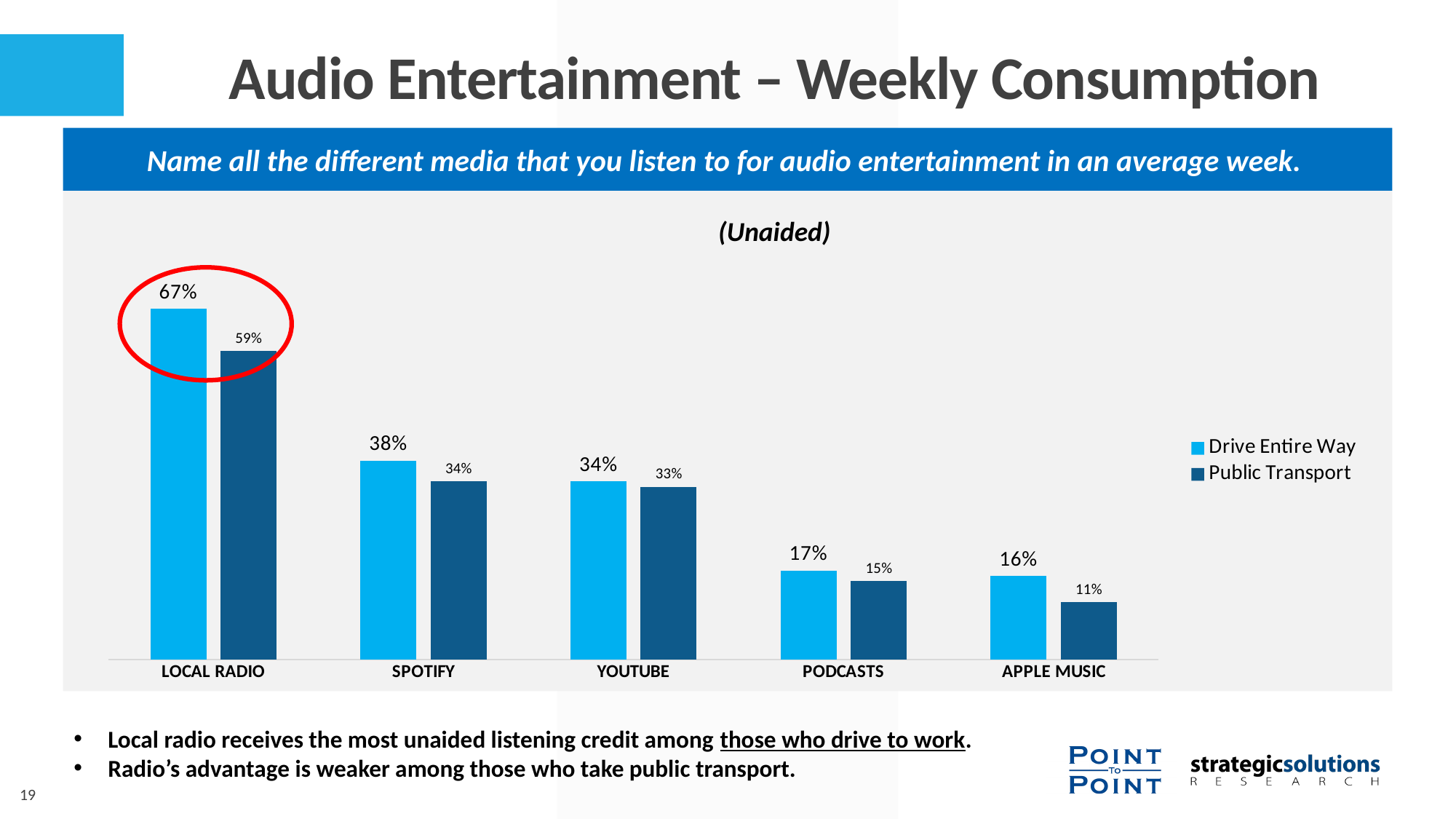
Which category has the highest Drive Entire Way value? Local Radio What is the Public Transport value for Apple Music? 11% What is the difference between the Drive Entire Way and Public Transport values for Local Radio? 8% Which category is circled in red on the chart? Local Radio How many categories are shown on the x axis? 5 Which is larger for Podcasts: the Drive Entire Way value or the Public Transport value? Drive Entire Way What is the Public Transport value for Spotify? 34% What kind of chart is shown on the slide? Bar chart Which category has the lowest Public Transport value? Apple Music What is the Drive Entire Way value for Local Radio? 67% What is the difference between the Drive Entire Way values for Spotify and YouTube? 4% How many series does the legend list? 2